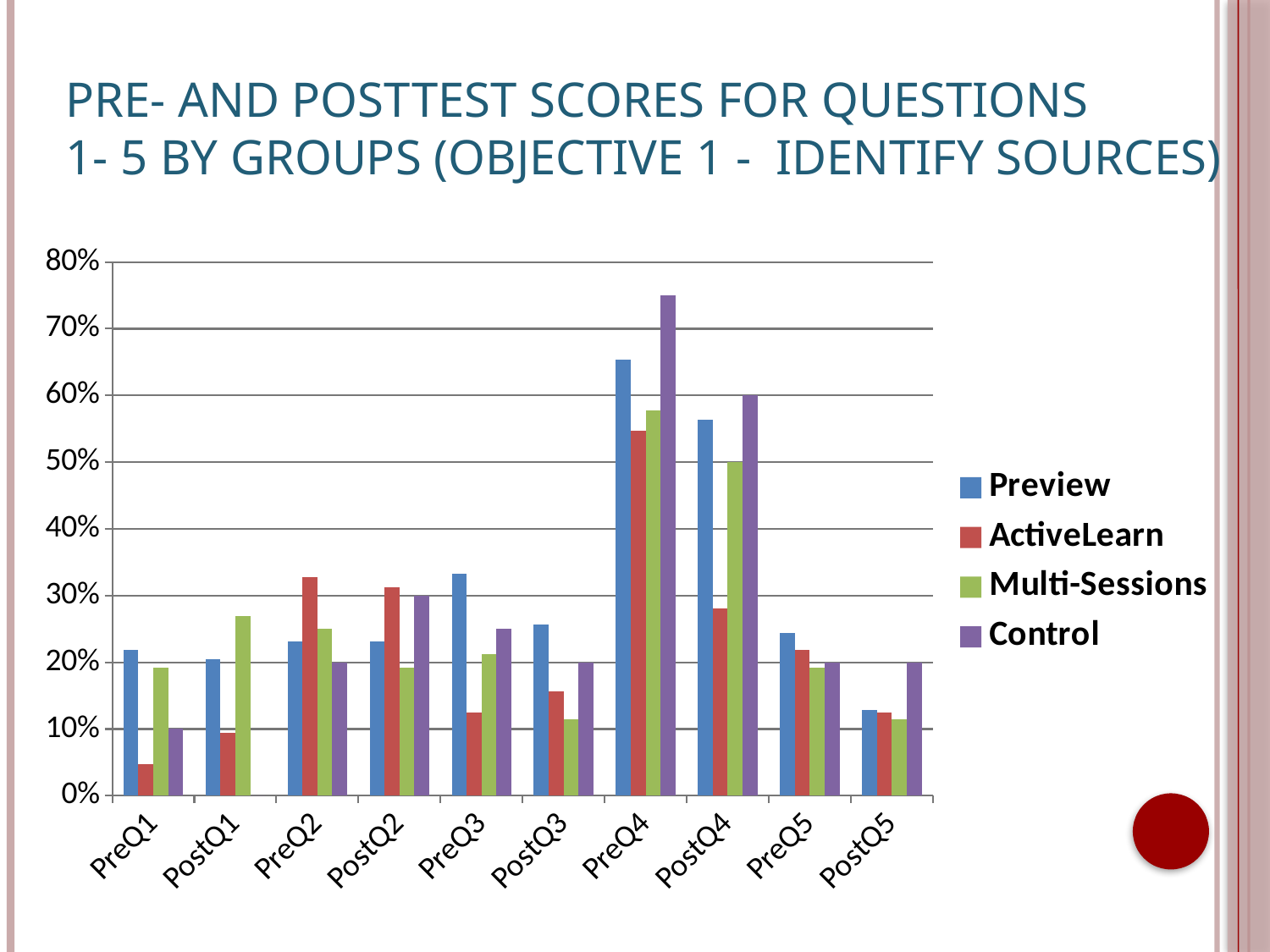
What kind of chart is shown on the slide? bar chart Which series are listed in the legend? Preview, ActiveLearn, Multi-Sessions, Control How many series does the legend list? 4 Is the Multi-Sessions value for PostQ1 greater or less than 20%? greater At PostQ4, which is larger: the Preview value or the ActiveLearn value? Preview At PreQ2, which is larger: the Preview value or the ActiveLearn value? ActiveLearn For which category is the Control value highest? PreQ4 Is the ActiveLearn value for PreQ1 greater or less than 10%? less Which series has the lowest value at PreQ1? ActiveLearn How many categories are shown along the x axis? 10 Is the Preview value for PreQ4 greater or less than 60%? greater